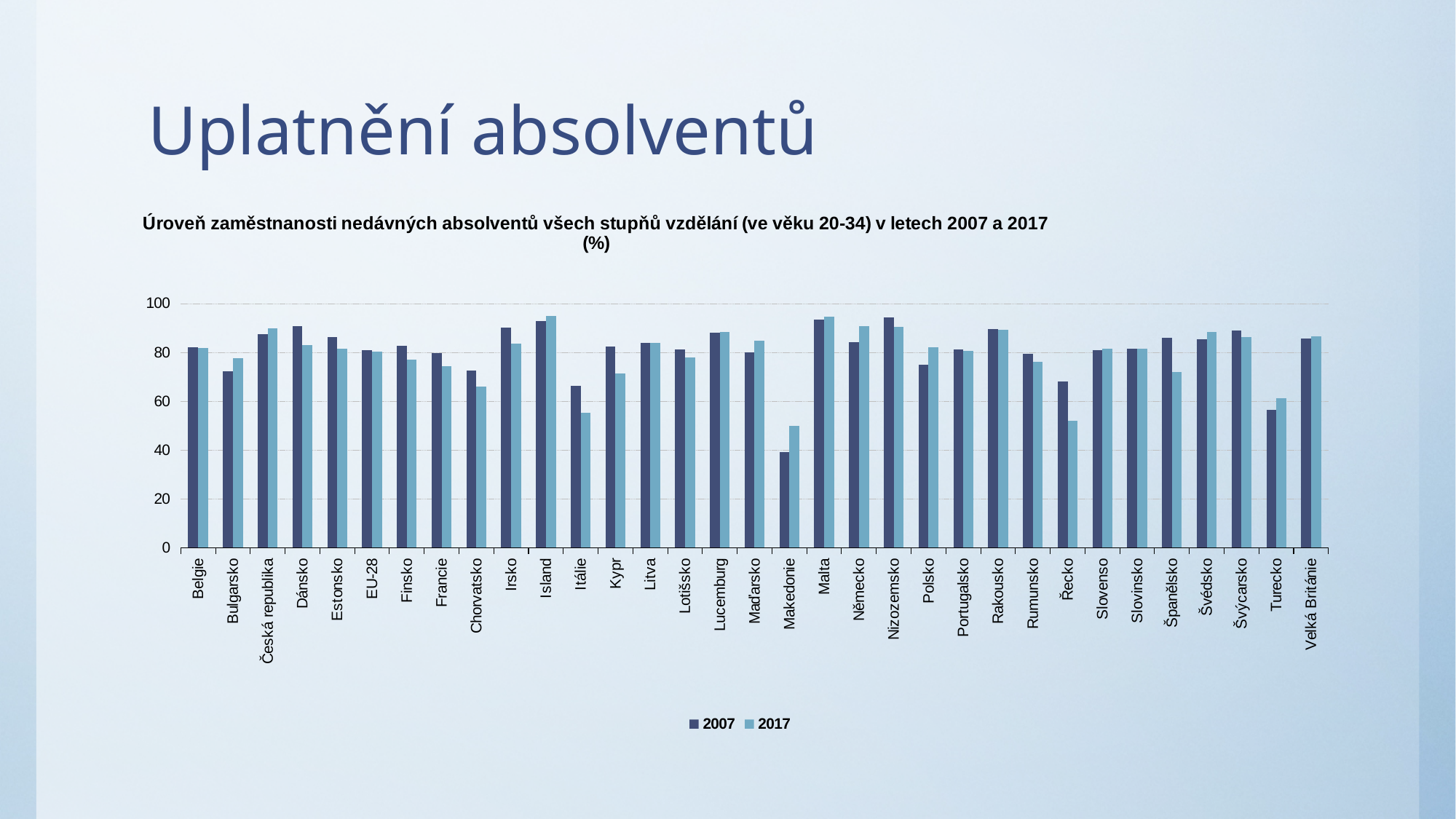
For Makedonie, which year has the larger value, 2007 or 2017? 2017 How many series does the legend list? 2 Is the value for Turecko in 2007 greater or less than 60? less Which category has the lowest value for 2007? Makedonie Which years are listed in the legend? 2007 and 2017 For Řecko, which year has the larger value, 2007 or 2017? 2007 For Turecko, which year has the larger value, 2007 or 2017? 2017 Is the value for Řecko in 2017 greater or less than 60? less Is the value for Itálie in 2017 greater or less than 60? less How many countries/categories are shown on the x axis? 33 What kind of chart is shown on the slide? bar chart